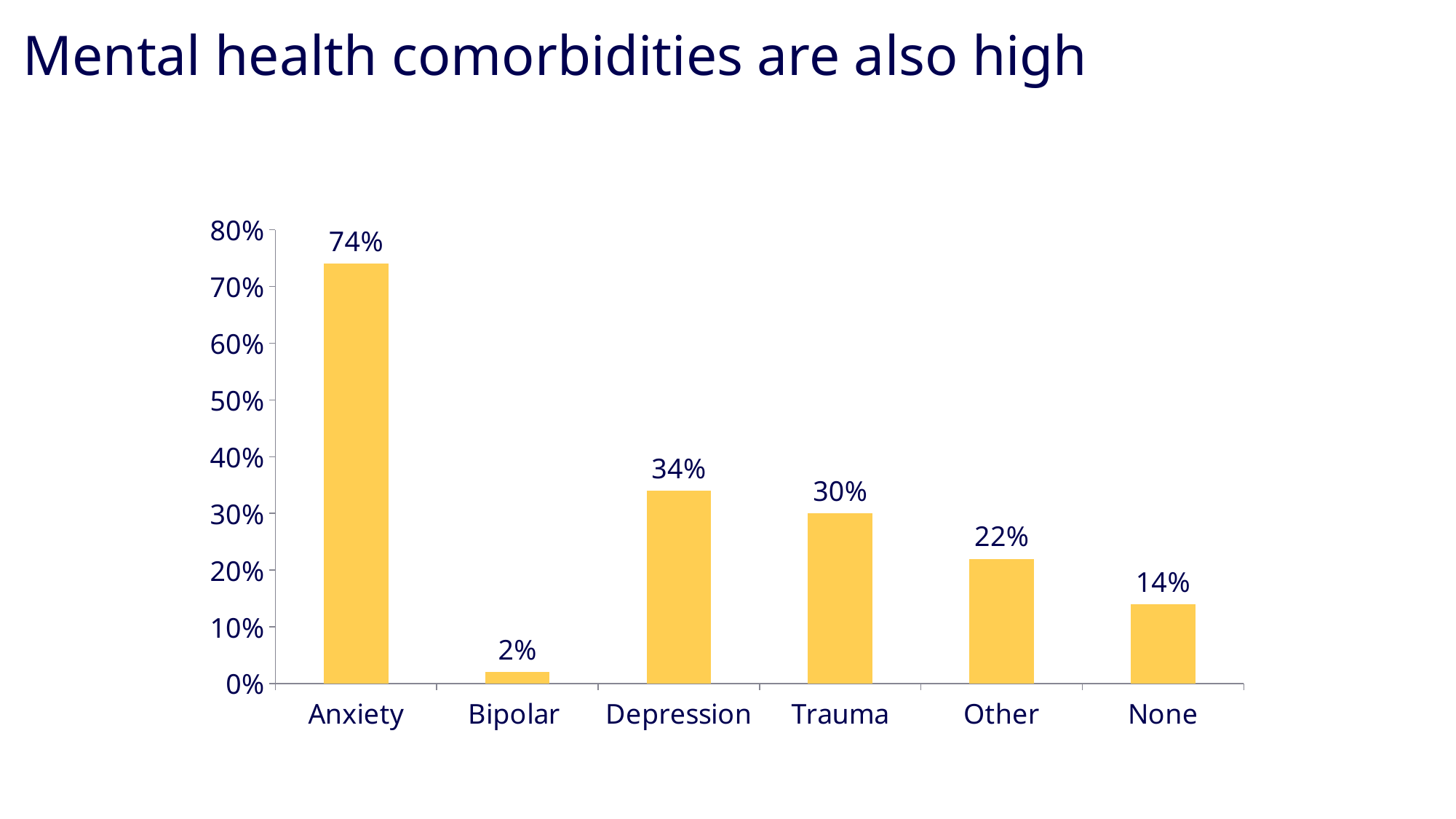
Is the value for Other greater or less than 30%? less Which category has the highest value? Anxiety Which category has the lowest value? Bipolar What is the difference between the values for Trauma and Other? 8% What is the value for None? 14% What is the value for Anxiety? 74% What is the value for Depression? 34% How many categories are shown on the x axis? 6 Which is larger, the value for Depression or the value for Trauma? Depression What kind of chart is shown on the slide? bar chart What is the title of the slide? Mental health comorbidities are also high What is the difference between the values for Anxiety and Depression? 40%